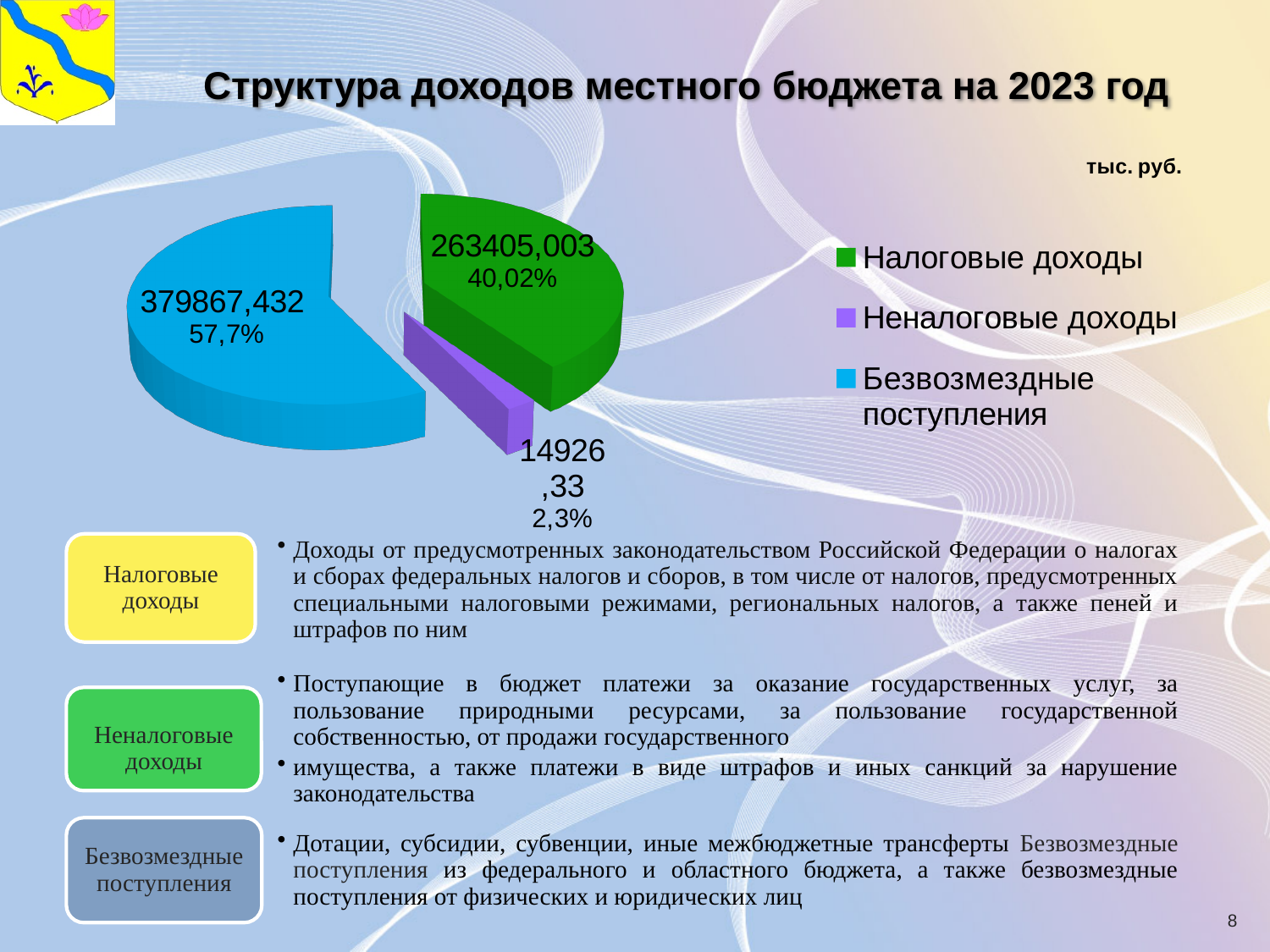
Which category has the largest slice of the pie? Безвозмездные поступления What share of the pie does Неналоговые доходы take? 2,3% What is the value for Безвозмездные поступления? 379867,432 What share of the pie does Безвозмездные поступления take? 57,7% What share of the pie does Налоговые доходы take? 40,02% Which category has the smallest slice of the pie? Неналоговые доходы What is the difference between Безвозмездные поступления and Налоговые доходы? 116462,429 What is the value for Неналоговые доходы? 14926,33 What is the value for Налоговые доходы? 263405,003 How many categories does the legend list? 3 What kind of chart is shown on the slide? pie chart Which is larger, Налоговые доходы or Неналоговые доходы? Налоговые доходы